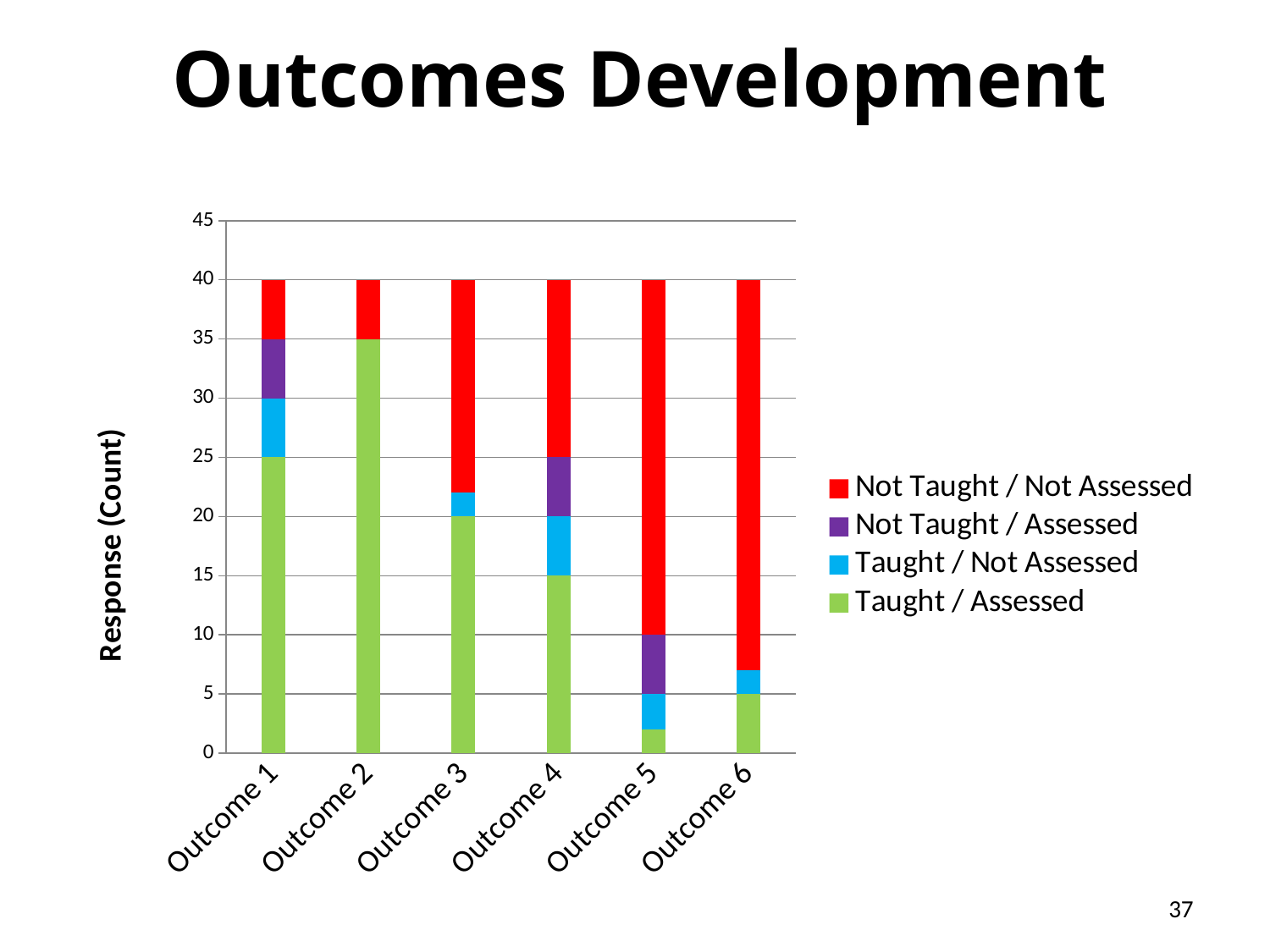
What is the total height of the stacked bar for Outcome 3? 40 Which outcome has the lowest Taught / Assessed value? Outcome 5 What is the Taught / Assessed value for Outcome 2? 35 What is the label of the y axis? Response (Count) What kind of chart is shown on the slide? Stacked bar chart How many outcome categories are shown on the x axis? 6 How many series does the legend list? 4 Which is larger, the Taught / Assessed value for Outcome 3 or for Outcome 4? Outcome 3 Which outcome has the highest Taught / Assessed value? Outcome 2 What is the Taught / Assessed value for Outcome 1? 25 What is the Taught / Assessed value for Outcome 4? 15 Is the Taught / Assessed value for Outcome 6 greater or less than 10? less